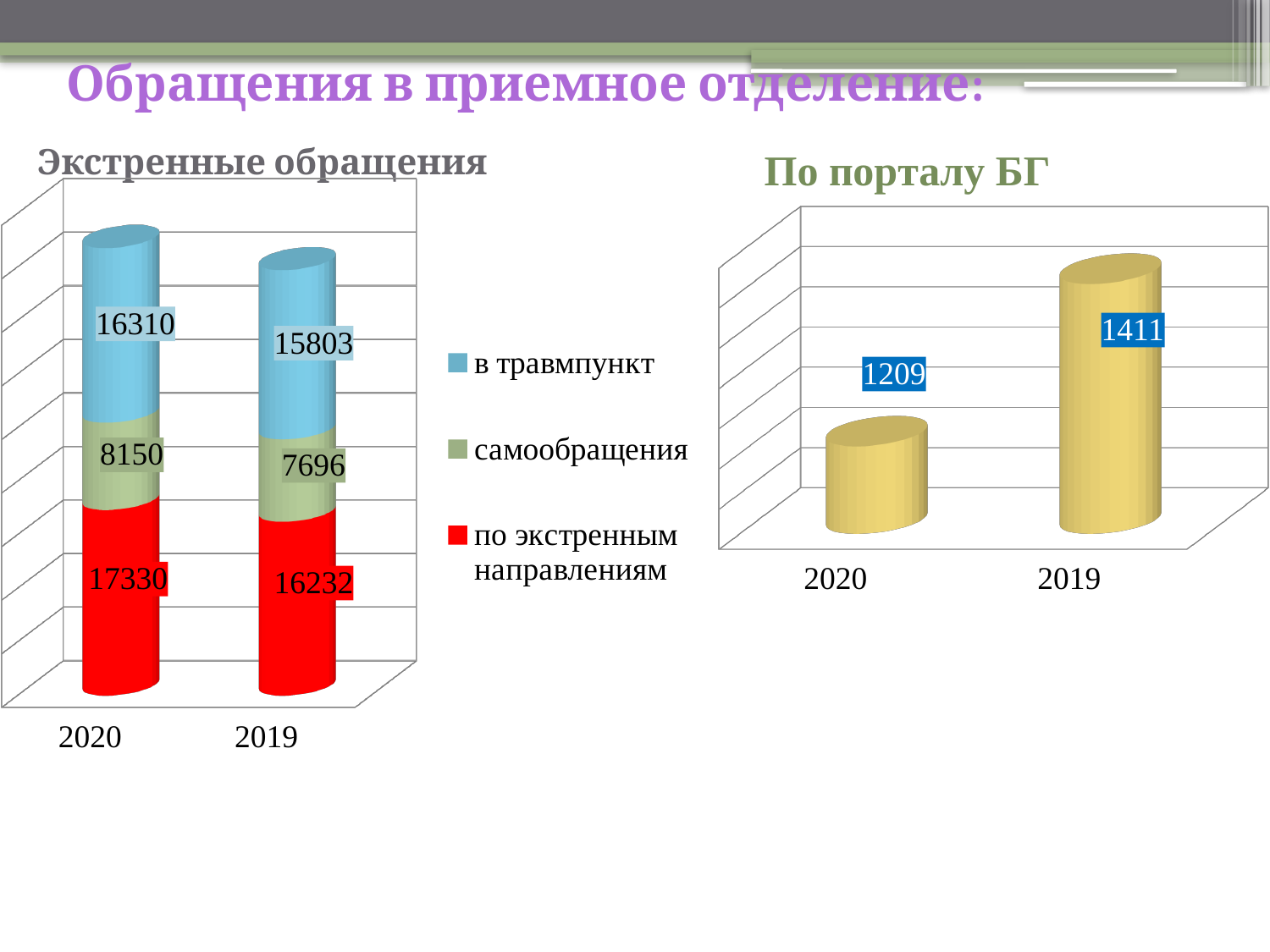
In the 'Экстренные обращения' chart, what is the value for 'по экстренным направлениям' in 2020? 17330 In the 'По порталу БГ' chart, which year has the lowest value? 2020 In the 'Экстренные обращения' chart, what is the total of the stacked bar for 2019? 39731 What kind of chart is the 'По порталу БГ' chart? bar chart In the 'Экстренные обращения' chart, what is the value for 'в травмпункт' in 2020? 16310 In the 'Экстренные обращения' chart, what is the total of the stacked bar for 2020? 41790 In the 'Экстренные обращения' chart, what is the value for 'самообращения' in 2019? 7696 In the 'По порталу БГ' chart, what is the value for 2019? 1411 In the 'Экстренные обращения' chart, how many series does the legend list? 3 In the 'Экстренные обращения' chart, which is larger: 'по экстренным направлениям' in 2020 or in 2019? 2020 In the 'По порталу БГ' chart, what is the difference between the 2019 and 2020 values? 202 In the 'Экстренные обращения' chart, what is the difference between 'в травмпункт' in 2020 and 2019? 507